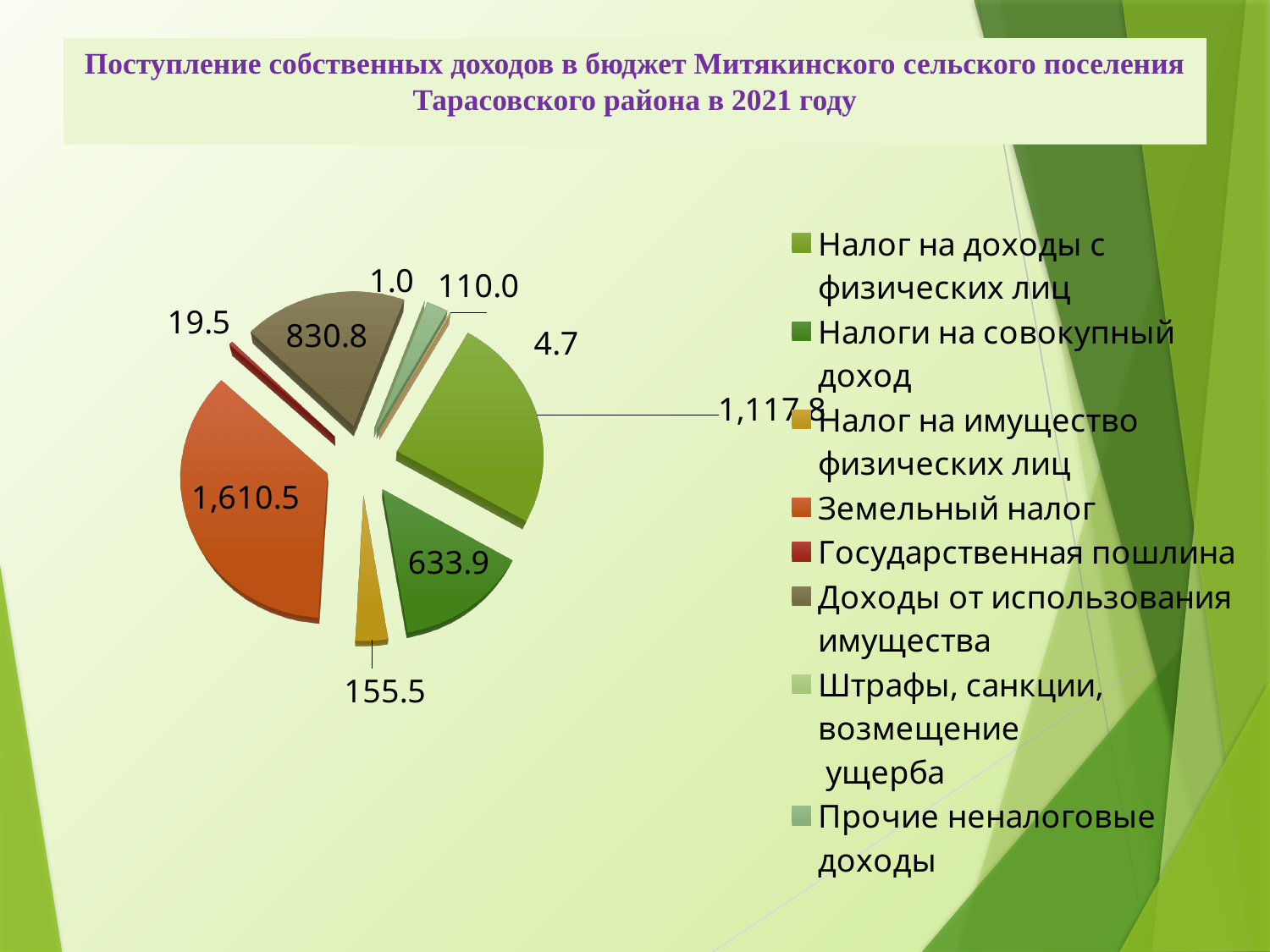
What is the value shown for Доходы от использования имущества? 830.8 What is the value shown for Государственная пошлина? 19.5 Which is larger: Доходы от использования имущества or Налоги на совокупный доход? Доходы от использования имущества What kind of chart is shown on the slide? pie chart What is the value shown for Налоги на совокупный доход? 633.9 What is the value shown for Налог на имущество физических лиц? 155.5 What is the value shown for Налог на доходы с физических лиц? 1,117.8 What colour is the slice for Земельный налог? orange What is the difference between the values for Земельный налог and Налог на доходы с физических лиц? 492.7 How many entries does the legend of the pie chart list? 8 What is the value shown for Земельный налог? 1,610.5 Which category has the largest slice of the pie? Земельный налог